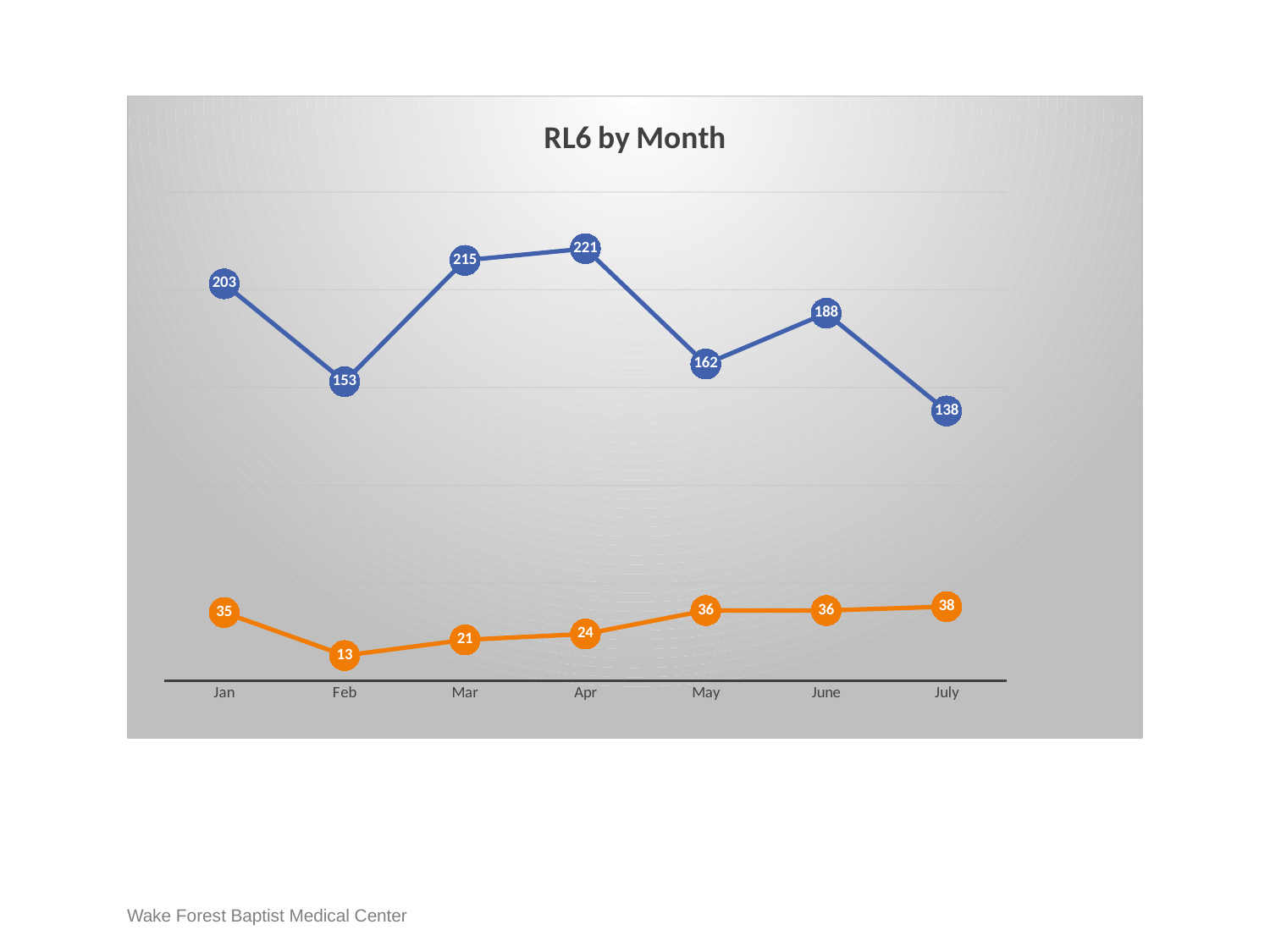
What is the difference between the blue line's values in March and February? 62 What kind of chart is shown on the slide? line chart In which month does the blue line reach its highest value? Apr How many months are shown along the x axis? 7 What is the value of the orange line in February? 13 Does the orange line rise or fall from February to July? rise In which month does the orange line reach its lowest value? Feb How many lines are plotted on the chart? 2 What is the value of the blue line in April? 221 Which is larger for the blue line: the value in January or the value in June? January In which month does the blue line reach its lowest value? July What is the title of the chart? RL6 by Month